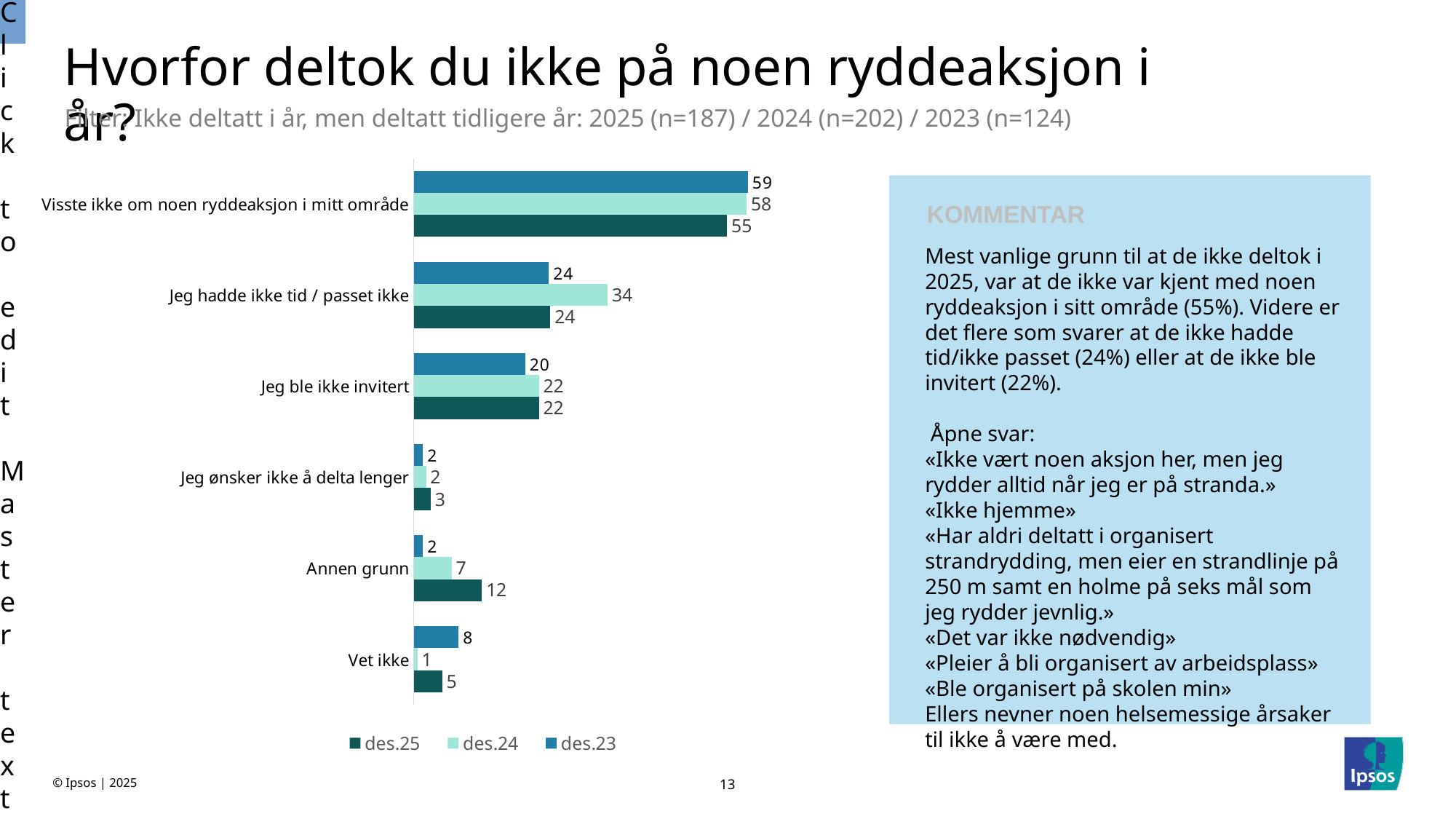
Which category has the lowest value in the des.24 series? Vet ikke How many series does the legend list? 3 Which category has the highest value in the des.25 series? Visste ikke om noen ryddeaksjon i mitt område Which series is shown in the lightest colour in the legend? des.24 What is the value for "Annen grunn" in the des.25 series? 12 What is the difference between the des.24 and des.25 values for "Jeg hadde ikke tid / passet ikke"? 10 What is the value for "Vet ikke" in the des.23 series? 8 What is the value for "Jeg hadde ikke tid / passet ikke" in the des.24 series? 34 For "Annen grunn", which series has the larger value, des.25 or des.23? des.25 What kind of chart is shown on the slide? Bar chart How many categories are shown on the chart? 6 What is the value for "Visste ikke om noen ryddeaksjon i mitt område" in the des.25 series? 55